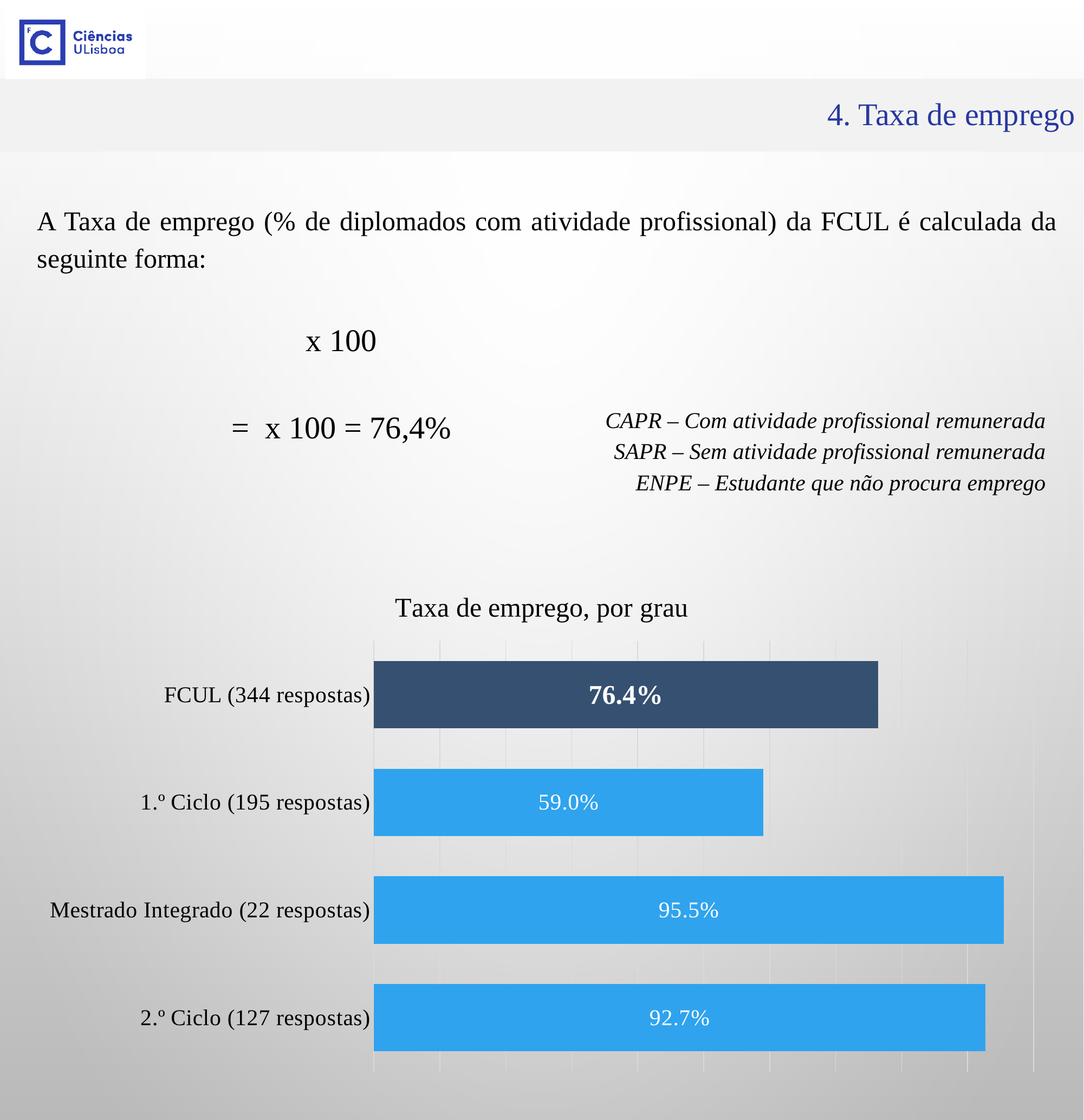
What is the difference between the values for Mestrado Integrado (22 respostas) and 2.º Ciclo (127 respostas)? 2.8% What type of chart is shown on the slide? bar chart Which is larger, the value for 2.º Ciclo (127 respostas) or the value for FCUL (344 respostas)? 2.º Ciclo (127 respostas) What is the value for FCUL (344 respostas)? 76.4% What is the value for Mestrado Integrado (22 respostas)? 95.5% What is the value for 2.º Ciclo (127 respostas)? 92.7% What is the difference between the values for FCUL (344 respostas) and 1.º Ciclo (195 respostas)? 17.4% Which category has the highest value? Mestrado Integrado (22 respostas) How many categories are shown in the chart? 4 What is the value for 1.º Ciclo (195 respostas)? 59.0% Which category has the lowest value? 1.º Ciclo (195 respostas) What is the title of the chart? Taxa de emprego, por grau